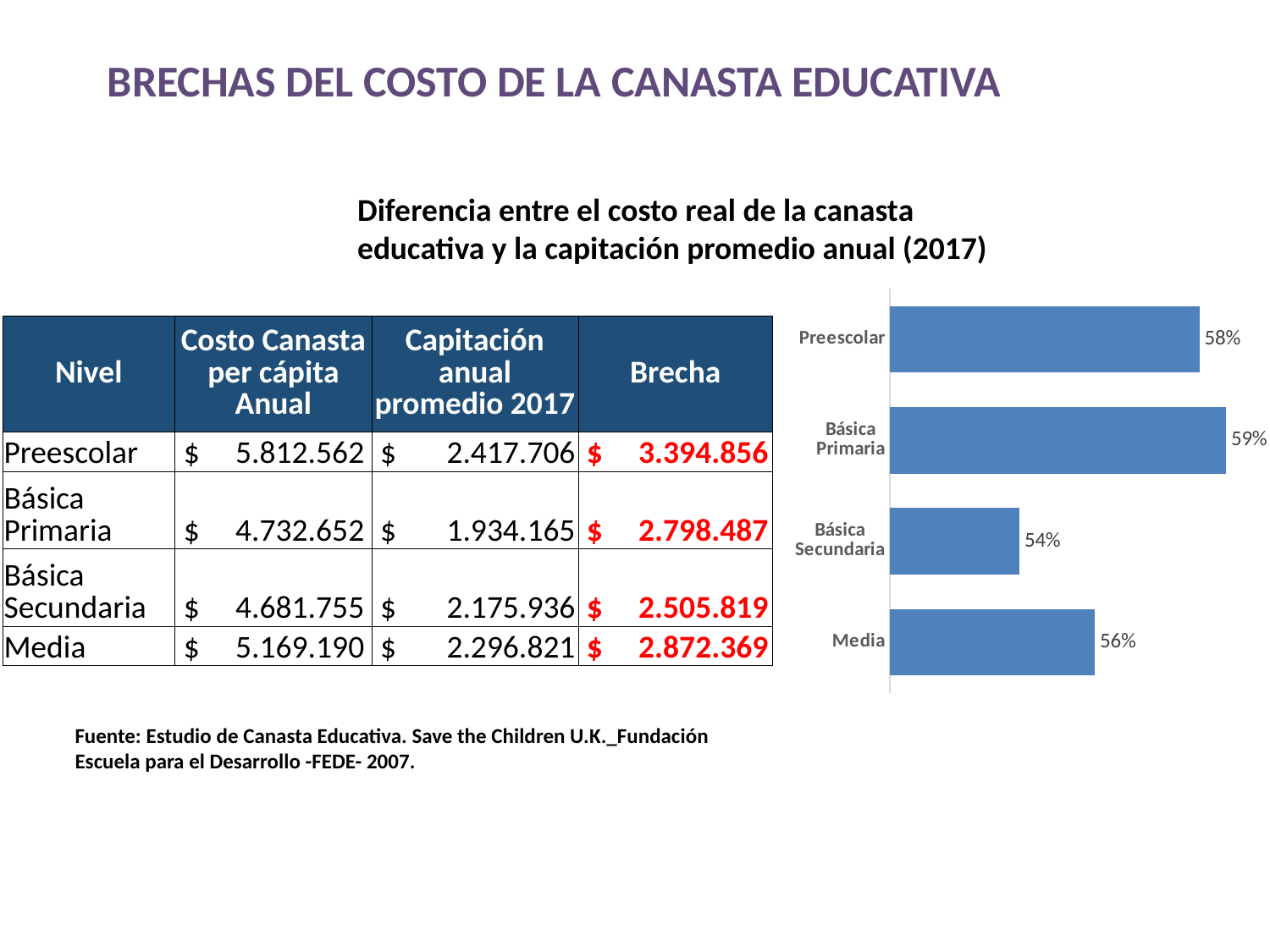
Which category has the lowest value in the bar chart? Básica Secundaria What kind of chart is shown on the slide? Bar chart What is the title of the chart on the slide? Diferencia entre el costo real de la canasta educativa y la capitación promedio anual (2017) What is the difference between the values for Básica Primaria and Básica Secundaria in the bar chart? 5% What is the value shown for Básica Primaria in the bar chart? 59% What is the value shown for Media in the bar chart? 56% Which category has the highest value in the bar chart? Básica Primaria What is the difference between the values for Preescolar and Media in the bar chart? 2% What is the value shown for Básica Secundaria in the bar chart? 54% What is the value shown for Preescolar in the bar chart? 58% How many categories are shown in the bar chart? 4 In the bar chart, which is larger: the value for Media or the value for Básica Secundaria? Media